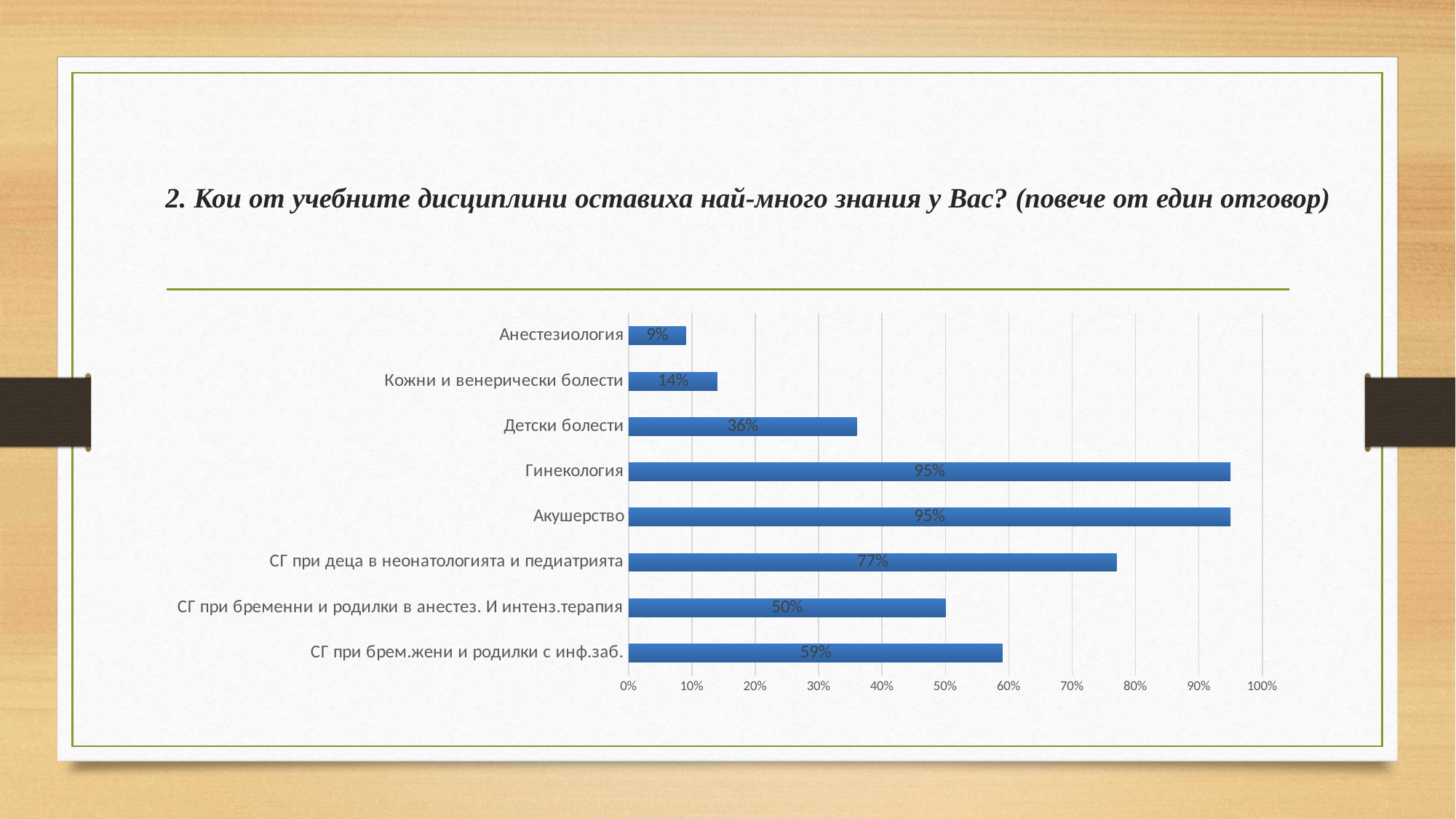
Which is larger, the value for Детски болести or the value for Кожни и венерически болести? Детски болести What is the value for Кожни и венерически болести? 14% What is the value for СГ при деца в неонатологията и педиатрията? 77% What kind of chart is shown on the slide? Bar chart What is the difference between the values for СГ при брем.жени и родилки с инф.заб. and СГ при бременни и родилки в анестез. И интенз.терапия? 9% What is the value for Акушерство? 95% Which category has the lowest value? Анестезиология What is the difference between the values for Гинекология and Детски болести? 59% What is the value for СГ при брем.жени и родилки с инф.заб.? 59% What is the value for Детски болести? 36% How many categories are shown in the chart? 8 What is the value for Анестезиология? 9%